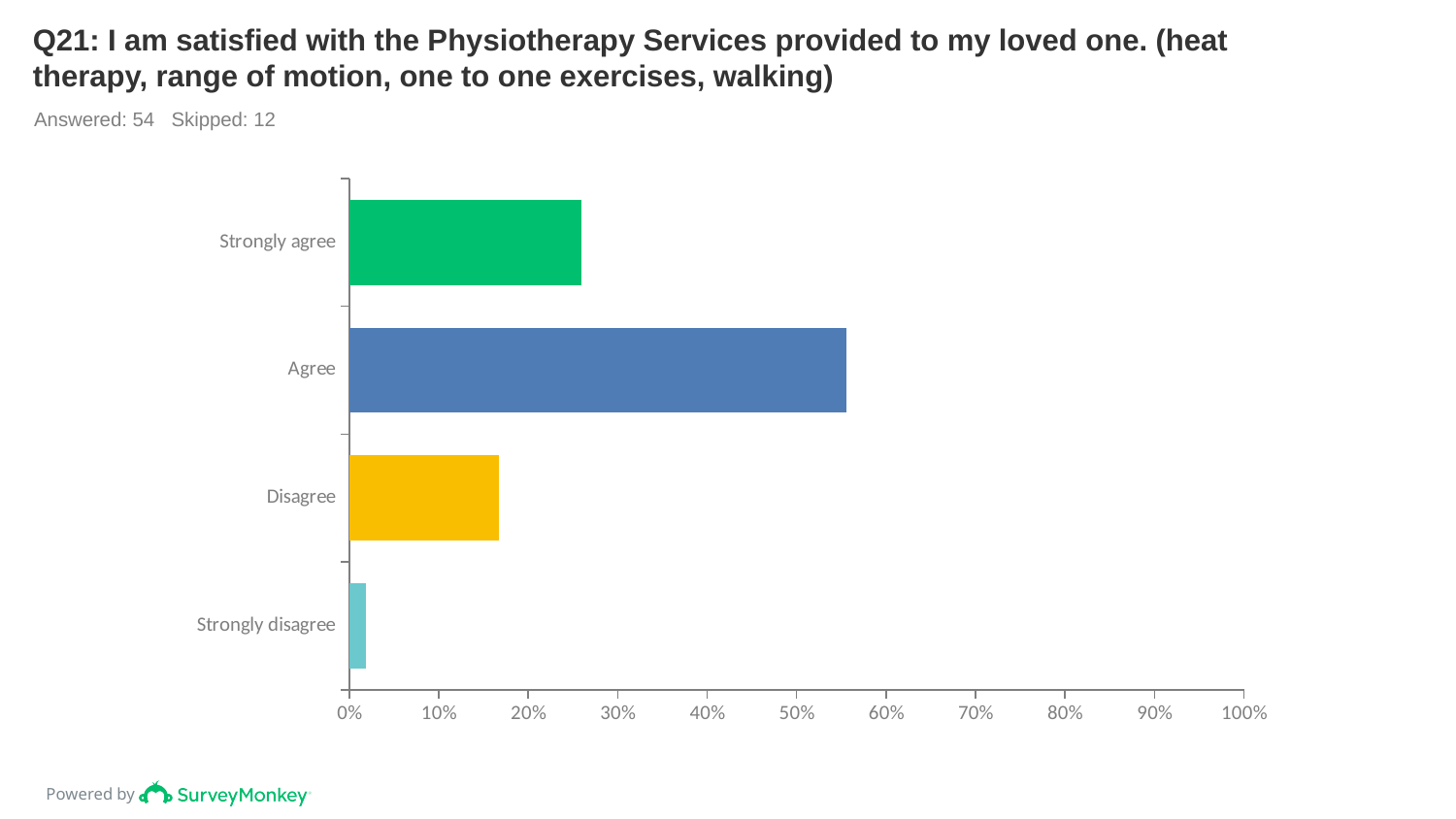
Which response category has the lowest value? Strongly disagree What kind of chart is shown on the slide? bar chart Which response category has the highest value? Agree Which is larger, the value for Strongly agree or the value for Disagree? Strongly agree Is the value for Disagree greater or less than 10%? greater How many respondents answered this question according to the slide? 54 What is the maximum value shown on the horizontal axis? 100% Is the value for Strongly agree greater or less than 30%? less Which is larger, the value for Agree or the value for Strongly agree? Agree How many response categories are shown in the chart? 4 Is the value for Agree greater or less than 50%? greater